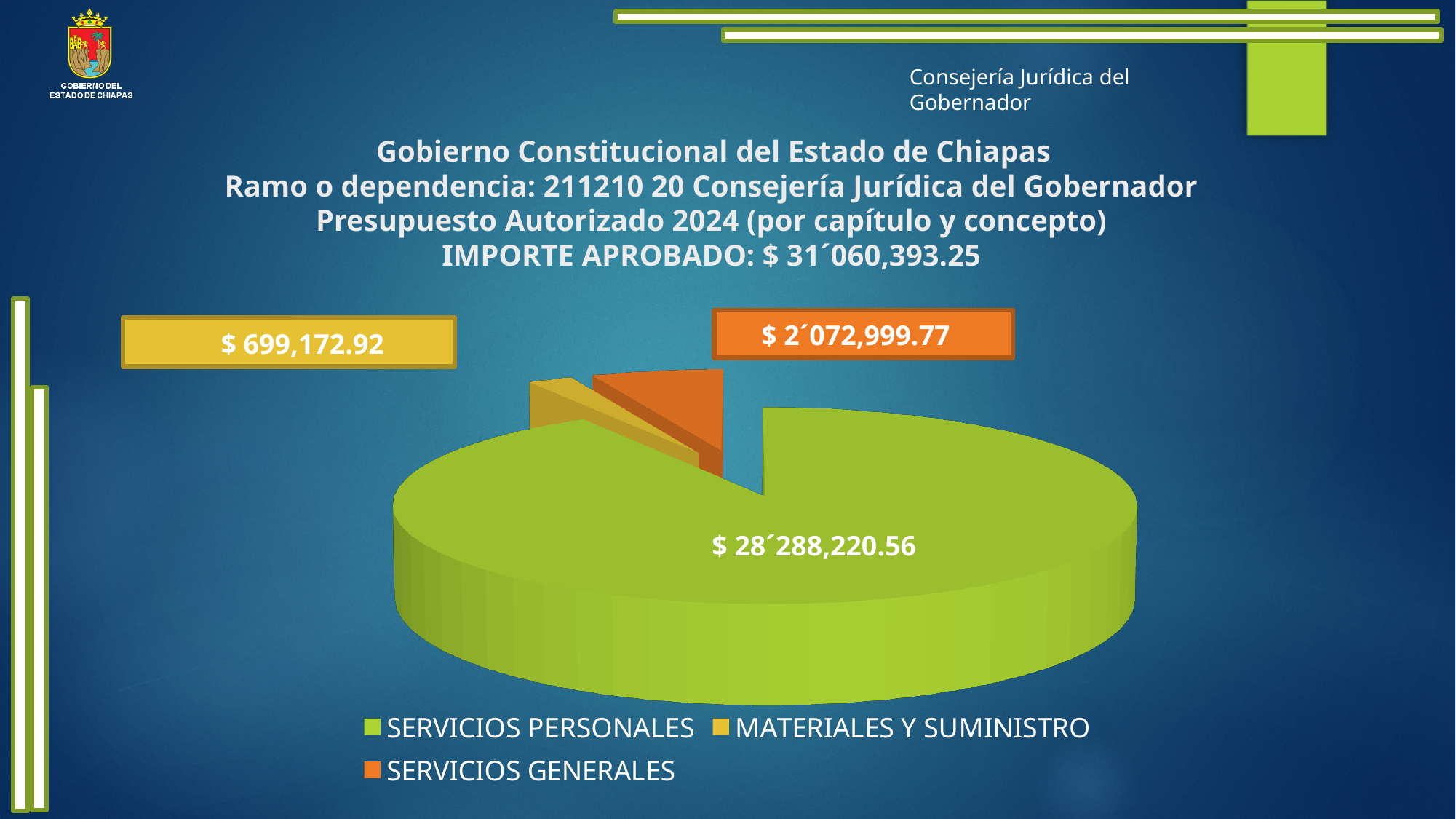
Which category has the smallest slice of the pie? MATERIALES Y SUMINISTRO What is the total of all three slices of the pie chart? $ 31´060,393.25 What is the value for SERVICIOS GENERALES? $ 2´072,999.77 What is the IMPORTE APROBADO stated in the chart title? $ 31´060,393.25 What is the value for MATERIALES Y SUMINISTRO? $ 699,172.92 What is the difference between SERVICIOS GENERALES and MATERIALES Y SUMINISTRO? $ 1´373,826.85 What colour is the slice for SERVICIOS GENERALES? Orange What is the value for SERVICIOS PERSONALES? $ 28´288,220.56 How many categories does the pie chart show? 3 What type of chart is shown on the slide? Pie chart Which category has the largest slice of the pie? SERVICIOS PERSONALES Which is larger, SERVICIOS GENERALES or MATERIALES Y SUMINISTRO? SERVICIOS GENERALES